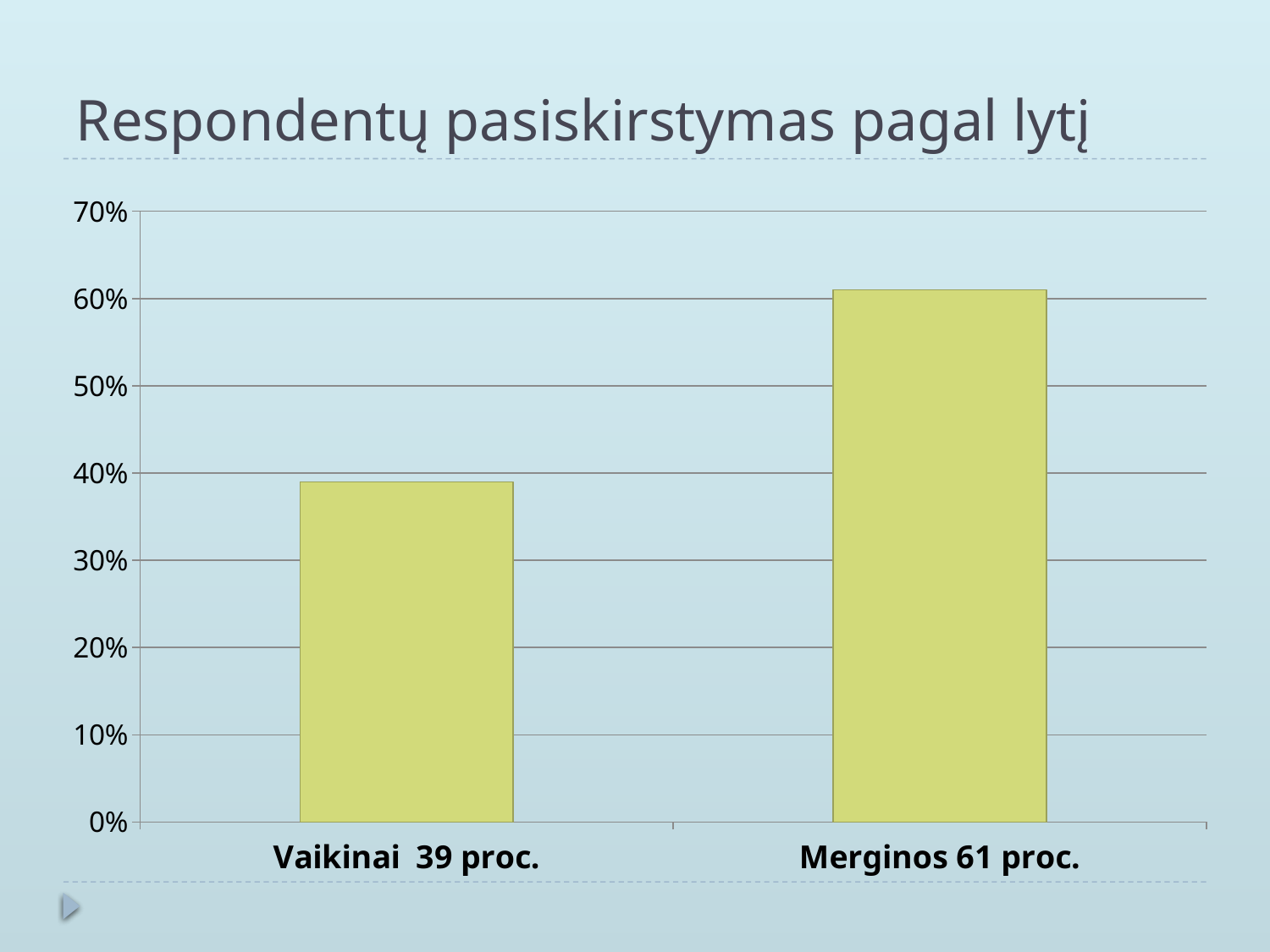
What is the title of the chart? Respondentų pasiskirstymas pagal lytį Is the value for Vaikinai greater or less than 40%? less What value is printed for Merginos? 61 proc. What is the highest value shown on the vertical axis? 70% What kind of chart is shown on the slide? bar chart How many categories are plotted in the chart? 2 What value is printed for Vaikinai? 39 proc. Which category has the highest value? Merginos Is the value for Merginos greater or less than 60%? greater Which is larger, the value for Vaikinai or the value for Merginos? Merginos Which category has the lowest value? Vaikinai What is the difference between the value for Merginos and the value for Vaikinai? 22 proc.